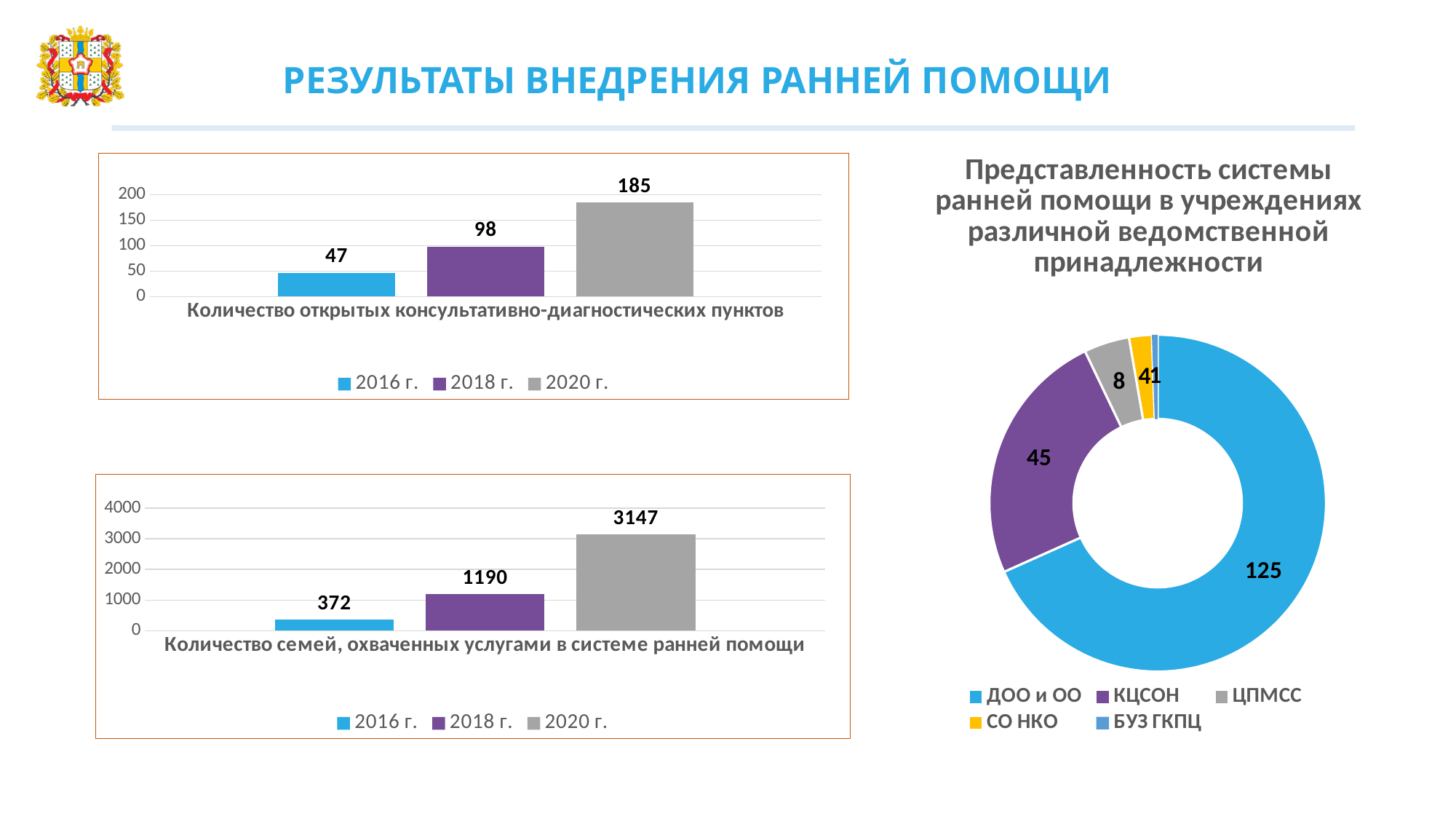
In the bottom-left bar chart (Количество семей, охваченных услугами в системе ранней помощи), what is the value for 2018 г.? 1190 In the top-left bar chart (Количество открытых консультативно-диагностических пунктов), what is the value for 2016 г.? 47 In the doughnut chart on the right, what is the value for КЦСОН? 45 In the bottom-left bar chart (Количество семей, охваченных услугами в системе ранней помощи), which year has the highest value? 2020 г. In the bottom-left bar chart (Количество семей, охваченных услугами в системе ранней помощи), what is the difference between the 2020 г. and 2016 г. values? 2775 In the top-left bar chart (Количество открытых консультативно-диагностических пунктов), what is the difference between the 2020 г. and 2018 г. values? 87 In the doughnut chart on the right, which category has the largest value? ДОО и ОО What kind of chart is the chart on the right (Представленность системы ранней помощи в учреждениях различной ведомственной принадлежности)? doughnut (pie) chart In the bottom-left bar chart (Количество семей, охваченных услугами в системе ранней помощи), do the values rise or fall from 2016 г. to 2020 г.? rise In the top-left bar chart (Количество открытых консультативно-диагностических пунктов), how many series does the legend list? 3 In the doughnut chart on the right, which is larger: ЦПМСС or КЦСОН? КЦСОН In the top-left bar chart (Количество открытых консультативно-диагностических пунктов), what is the value for 2020 г.? 185